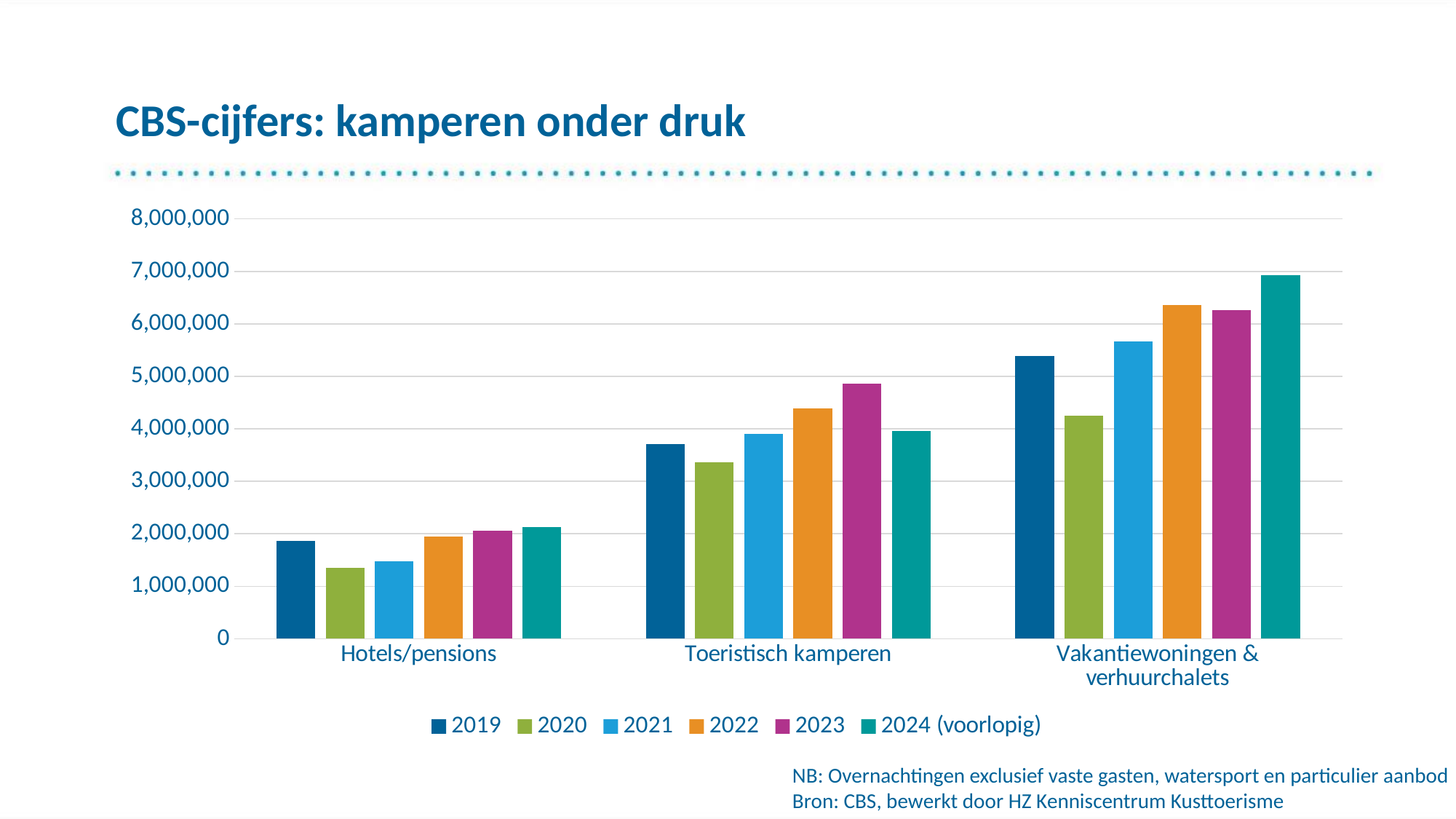
Which year has the lowest value for Hotels/pensions? 2020 Is the value for Hotels/pensions in 2020 greater or less than 2,000,000? less Which year has the lowest value for Vakantiewoningen & verhuurchalets? 2020 How many series does the legend list? 6 Is the value for Vakantiewoningen & verhuurchalets in 2024 (voorlopig) greater or less than 6,000,000? greater Is the value for Toeristisch kamperen in 2023 greater or less than 4,000,000? greater For Toeristisch kamperen, which is larger: the value for 2023 or for 2024 (voorlopig)? 2023 Which category and year has the highest bar in the whole chart? Vakantiewoningen & verhuurchalets, 2024 (voorlopig) What kind of chart is shown on the slide? bar chart How many categories are shown on the x axis? 3 Which year has the highest value for Toeristisch kamperen? 2023 What is the title of the slide? CBS-cijfers: kamperen onder druk